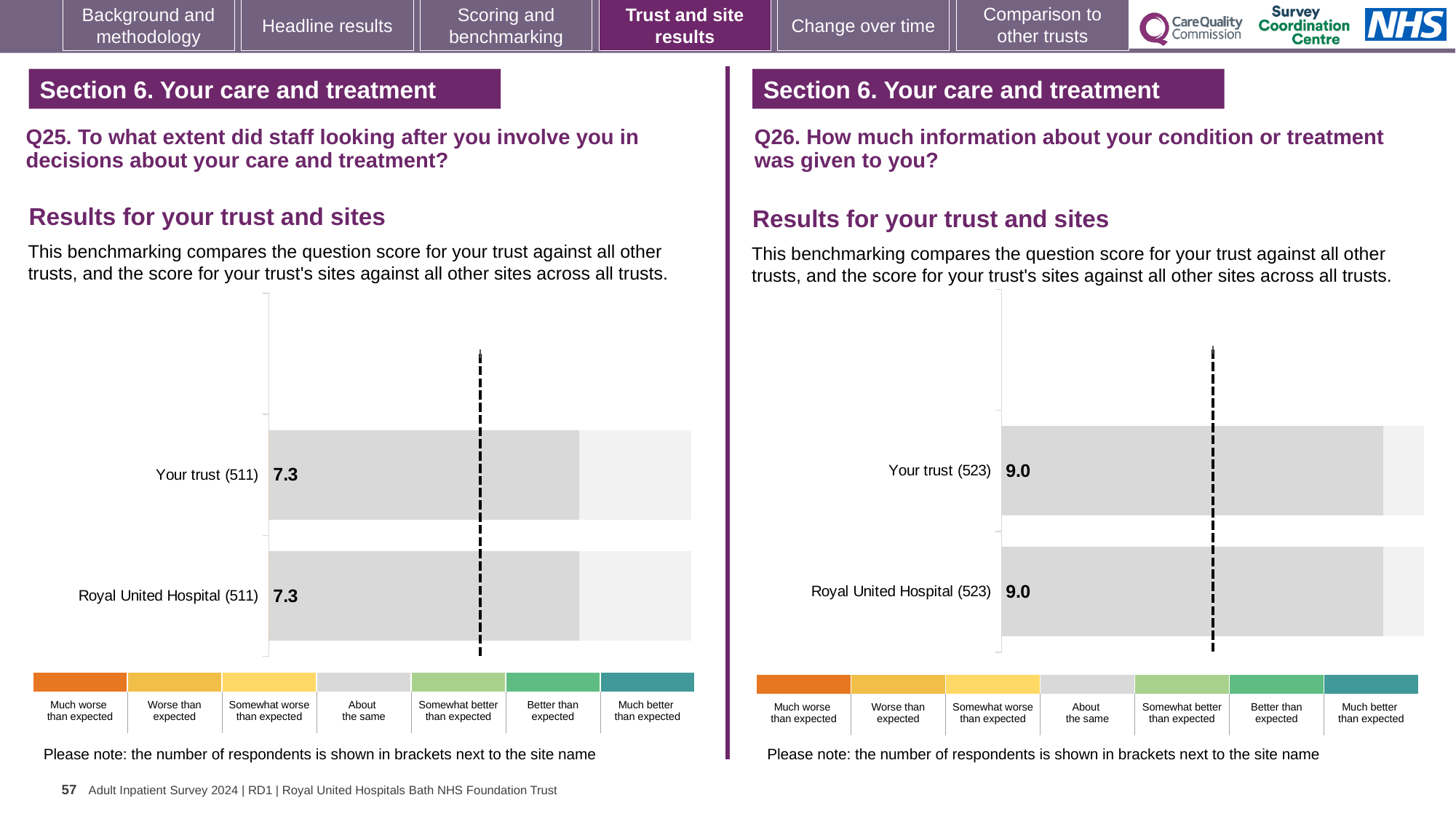
In the Q25 chart, what is the difference between the score for Your trust and the score for Royal United Hospital? 0.0 How many bars are plotted in the Q26 chart? 2 In the Q25 chart, what is the score for Your trust? 7.3 In the Q26 chart, what is the score for Royal United Hospital? 9.0 How many bars are plotted in the Q25 chart? 2 What kind of chart is used for the Q26 results? Bar chart In the Q26 chart, what is the score for Your trust? 9.0 In the Q25 chart, how many respondents are shown in brackets next to Your trust? 511 How many benchmark categories does the colour key below the Q25 chart list? 7 According to the colour key, which benchmark category do the grey bars in the Q26 chart represent? About the same In the Q25 chart, what is the score for Royal United Hospital? 7.3 In the Q26 chart, how many respondents are shown in brackets next to Royal United Hospital? 523